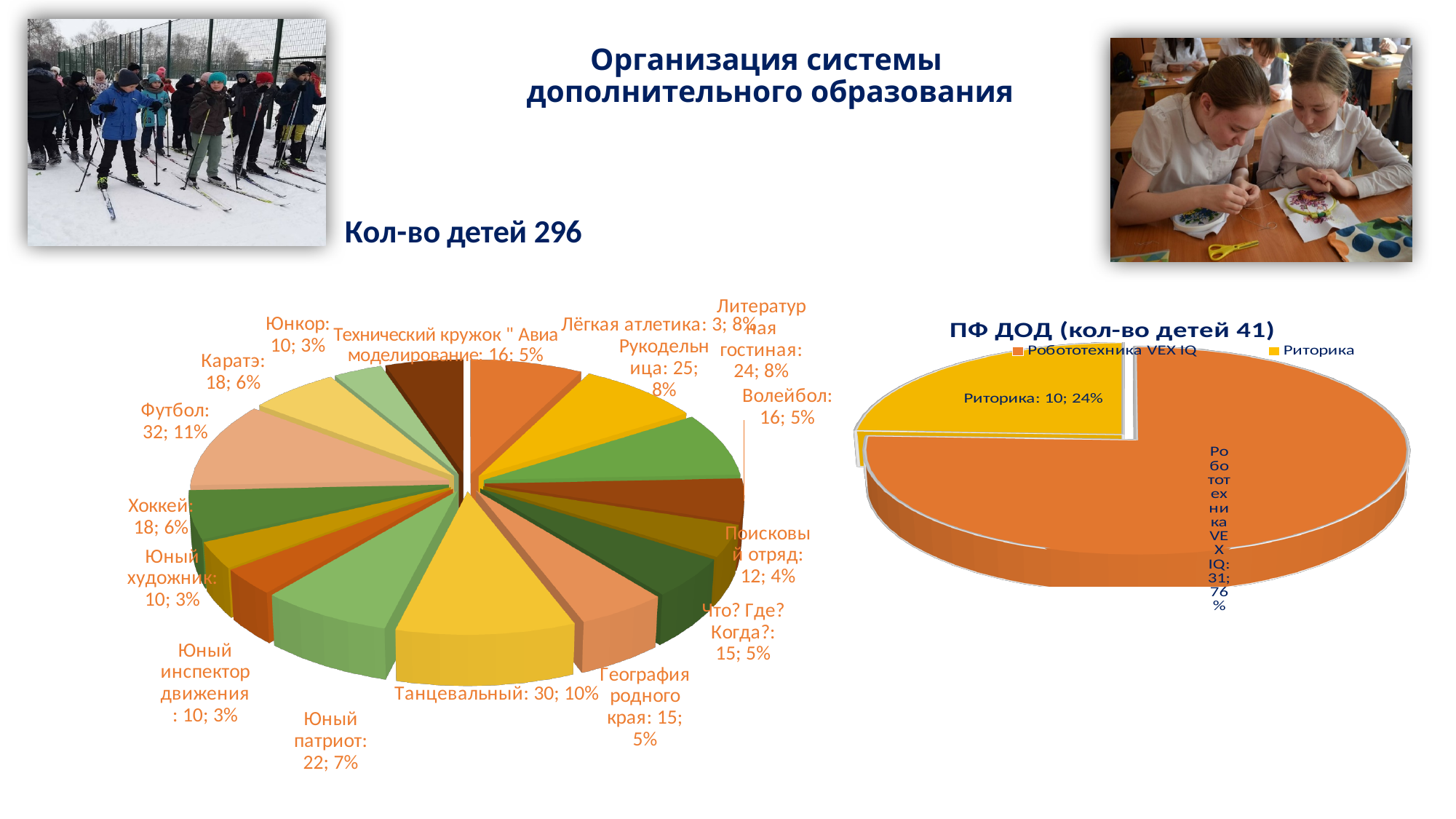
In the chart on the right titled "ПФ ДОД (кол-во детей 41)", what is the difference in number of children between Робототехника VEX IQ and Риторика? 21 In the chart on the right titled "ПФ ДОД (кол-во детей 41)", what share of the pie does Риторика have? 24% What kind of chart is the large chart on the left below "Кол-во детей 296"? pie chart In the chart on the right titled "ПФ ДОД (кол-во детей 41)", how many children are in Робототехника VEX IQ? 31 In the chart on the right titled "ПФ ДОД (кол-во детей 41)", which slice is larger, Робототехника VEX IQ or Риторика? Робототехника VEX IQ What kind of chart is the chart on the right titled "ПФ ДОД (кол-во детей 41)"? pie chart In the large pie chart on the left, what share of the pie does Танцевальный have? 10% In the large pie chart on the left, which has more children, Рукодельница or Волейбол? Рукодельница In the large pie chart on the left, how many children are in Футбол? 32 In the large pie chart on the left, which category has the highest number of children? Футбол How many entries does the legend of the chart on the right titled "ПФ ДОД (кол-во детей 41)" list? 2 In the large pie chart on the left, what is the difference in number of children between Футбол and Танцевальный? 2